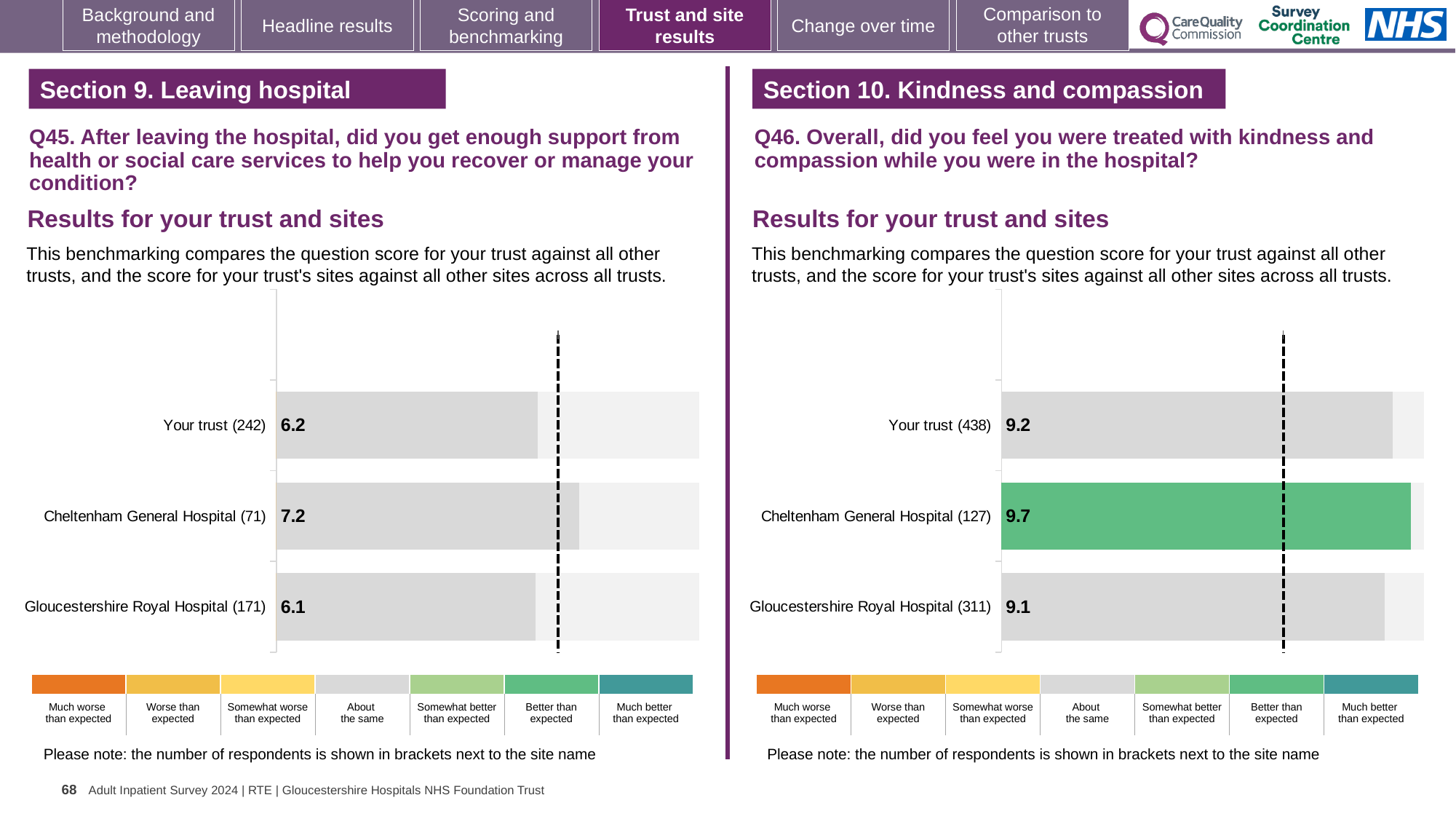
In the Q45 chart (left), what is the score for Cheltenham General Hospital? 7.2 What type of chart is used for the Q45 results on the left? Bar chart In the Q46 chart (right), which bar is coloured green rather than grey? Cheltenham General Hospital In the Q46 chart (right), which site or trust has the highest score? Cheltenham General Hospital In the Q45 chart (left), which site or trust has the lowest score? Gloucestershire Royal Hospital In the Q45 chart (left), what is the difference between the scores for Cheltenham General Hospital and Gloucestershire Royal Hospital? 1.1 In the Q45 chart (left), what is the score for Your trust? 6.2 In the Q46 chart (right), what is the score for Cheltenham General Hospital? 9.7 In the Q45 chart (left), how many respondents are shown for Your trust? 242 In the Q46 chart (right), how many bars are plotted? 3 In the Q46 chart (right), what is the difference between the scores for Cheltenham General Hospital and Your trust? 0.5 In the Q46 chart (right), what is the score for Gloucestershire Royal Hospital? 9.1